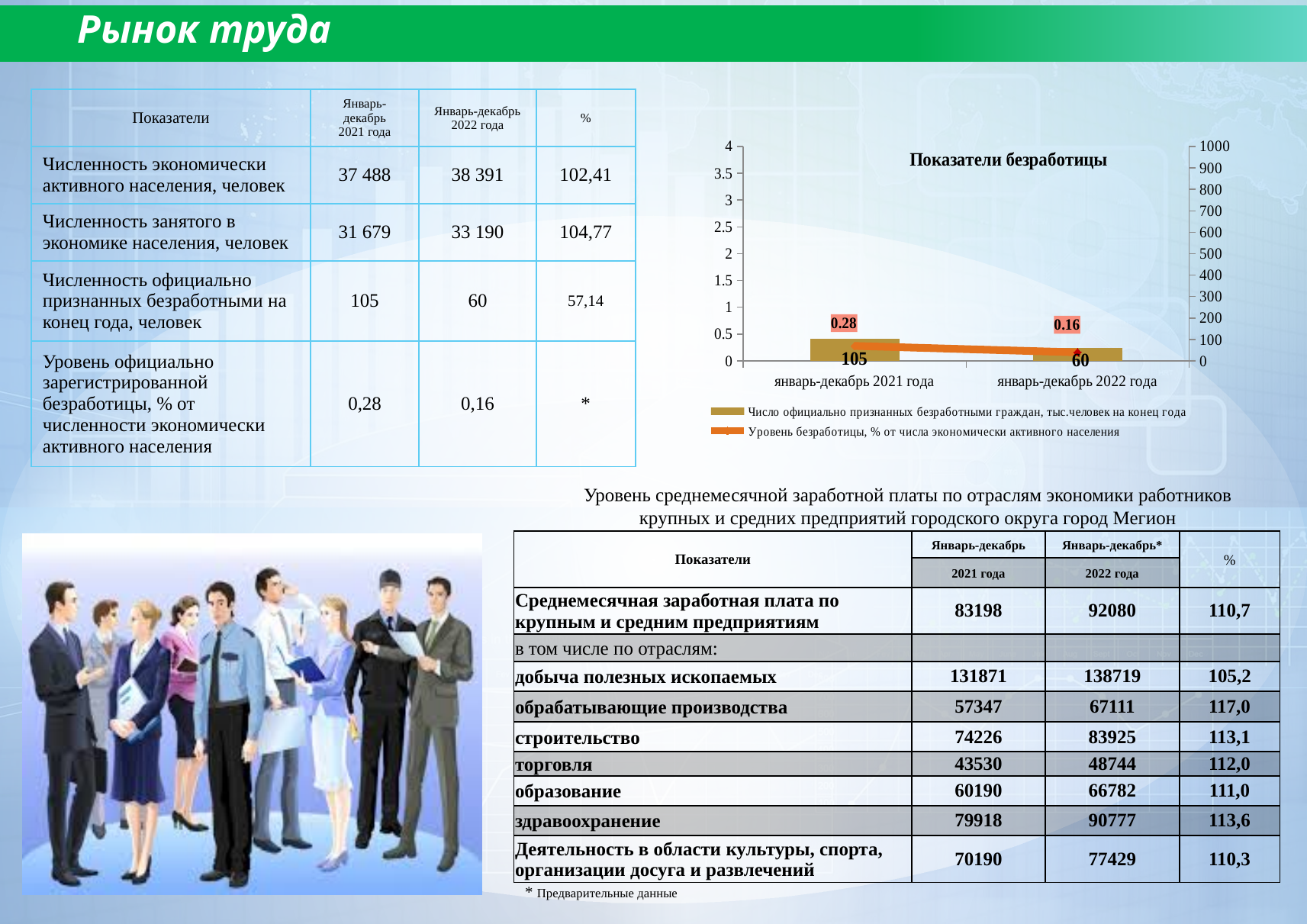
In the chart "Показатели безработицы", what is the difference between the unemployment rate values for 2021 and 2022? 0.12 How many periods (categories) are shown on the x axis of the chart "Показатели безработицы"? 2 What is the title of the chart on the slide? Показатели безработицы In the chart "Показатели безработицы", what is the value of the bar for январь-декабрь 2022 года? 60 In the chart "Показатели безработицы", what is the unemployment rate (Уровень безработицы) value for январь-декабрь 2022 года? 0.16 In the chart "Показатели безработицы", what is the difference between the bar values for 2021 and 2022? 45 In the chart "Показатели безработицы", what is the value of the bar for январь-декабрь 2021 года? 105 In the chart "Показатели безработицы", what is the unemployment rate (Уровень безработицы) value for январь-декабрь 2021 года? 0.28 In the chart "Показатели безработицы", which period has the lower unemployment rate? январь-декабрь 2022 года In the chart "Показатели безработицы", do the values rise or fall from 2021 to 2022? fall How many series does the legend of the chart "Показатели безработицы" list? 2 In the chart "Показатели безработицы", which period has the higher number of officially recognised unemployed citizens? январь-декабрь 2021 года